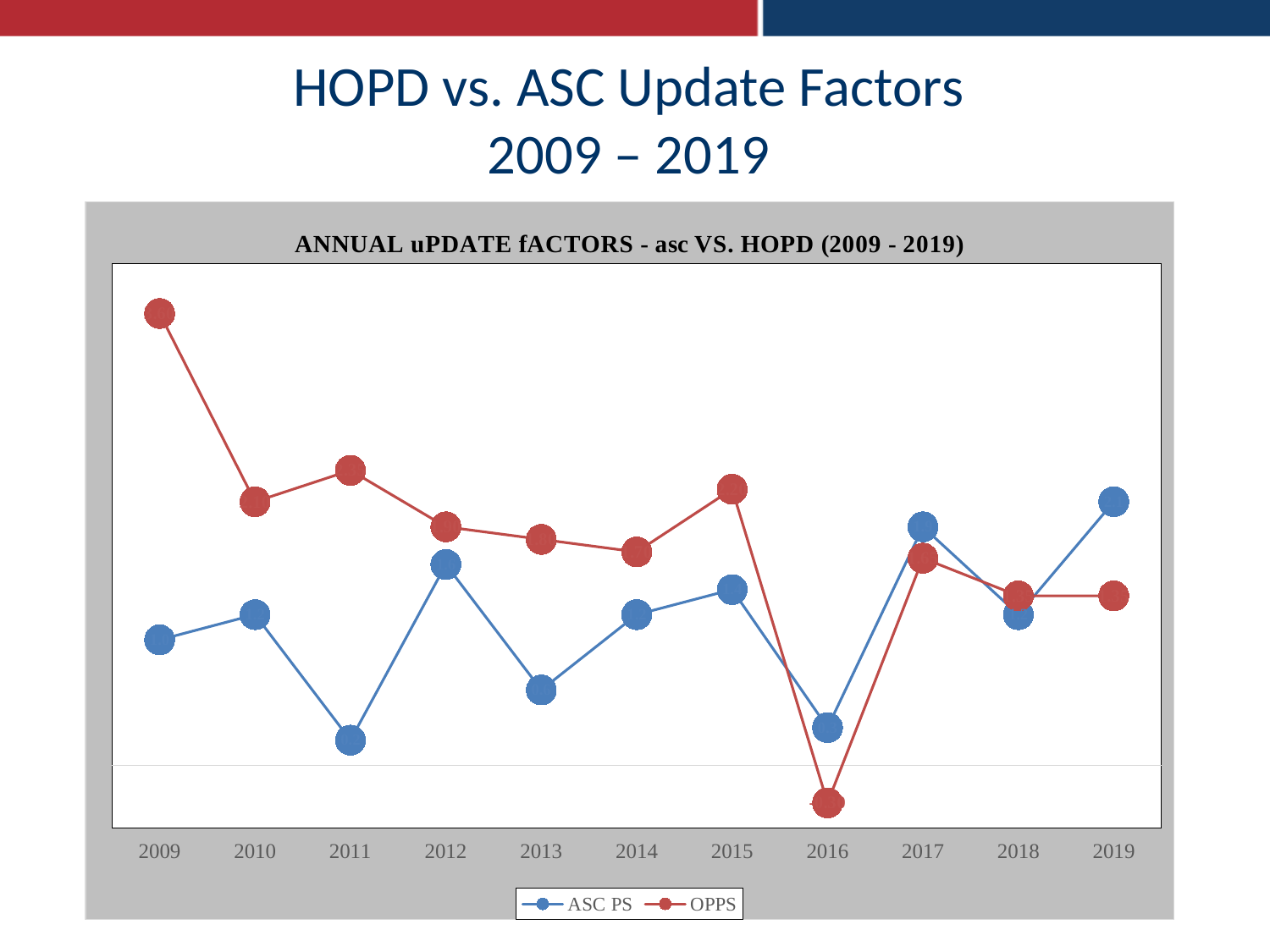
Does the ASC PS series rise or fall from 2016 to 2017? rise In which year is the ASC PS series at its highest? 2019 In which year is the OPPS series at its lowest? 2016 What kind of chart is shown on the slide? line chart In which year is the OPPS series at its highest? 2009 What colour is the line for the OPPS series? red Does the OPPS series rise or fall from 2009 to 2010? fall In 2016, which series has the higher value, ASC PS or OPPS? ASC PS How many years are plotted along the x axis? 11 In 2009, which series has the higher value, ASC PS or OPPS? OPPS How many series does the legend list? 2 In 2019, which series has the higher value, ASC PS or OPPS? ASC PS